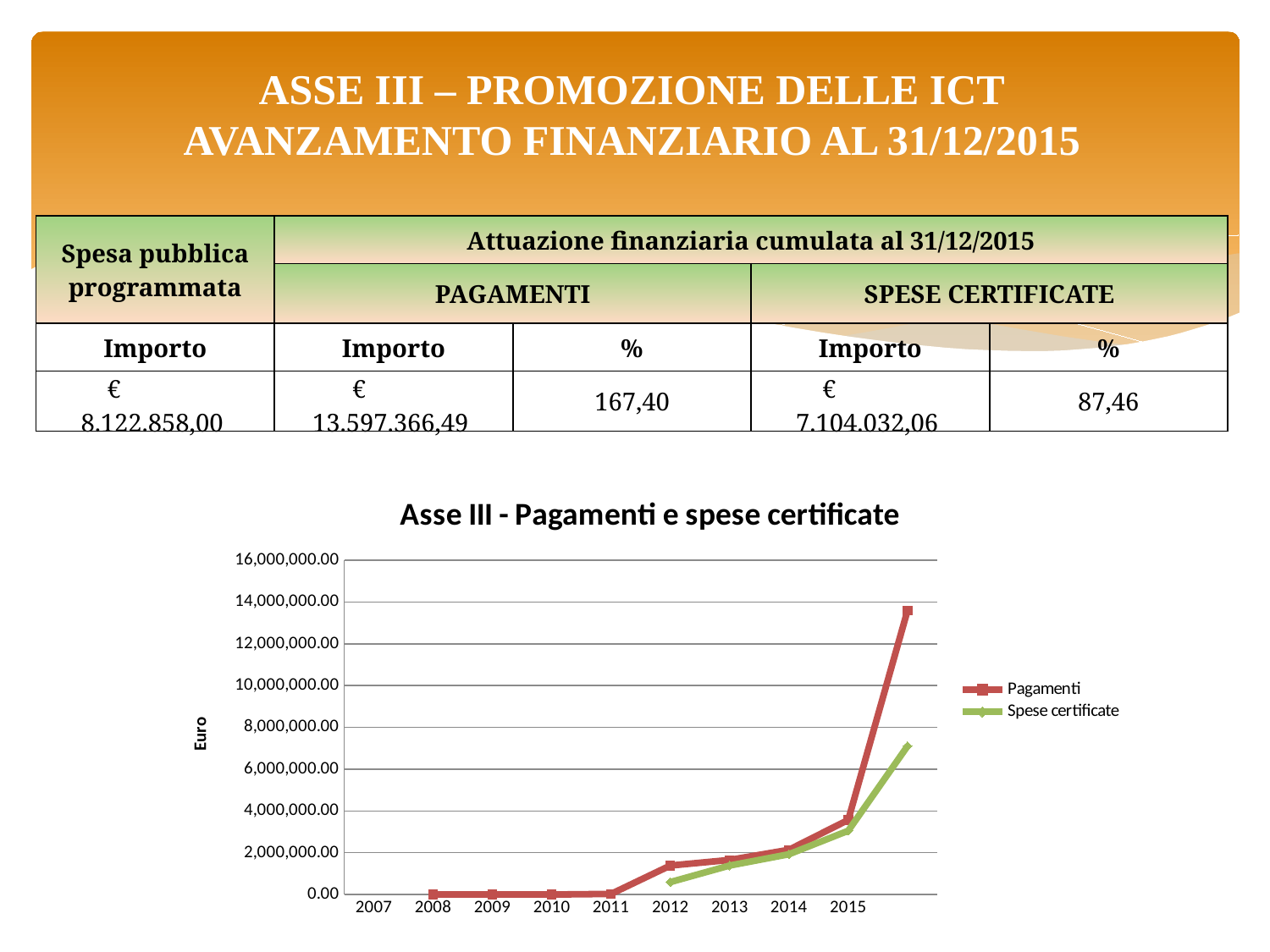
Is the final plotted value of the Spese certificate series greater or less than 8,000,000.00? less How many year labels are shown on the x axis of the chart? 9 Which series reaches the highest value on the chart? Pagamenti What is the title of the chart? Asse III - Pagamenti e spese certificate Is the final plotted value of the Spese certificate series greater or less than 6,000,000.00? greater What kind of chart is shown on the slide? line chart Is the first plotted value of the Spese certificate series greater or less than 2,000,000.00? less What is the label on the vertical axis of the chart? Euro At the final plotted point, which series has the higher value, Pagamenti or Spese certificate? Pagamenti How many series does the legend of the chart list? 2 Do the values of the Pagamenti series rise or fall along the x axis? rise